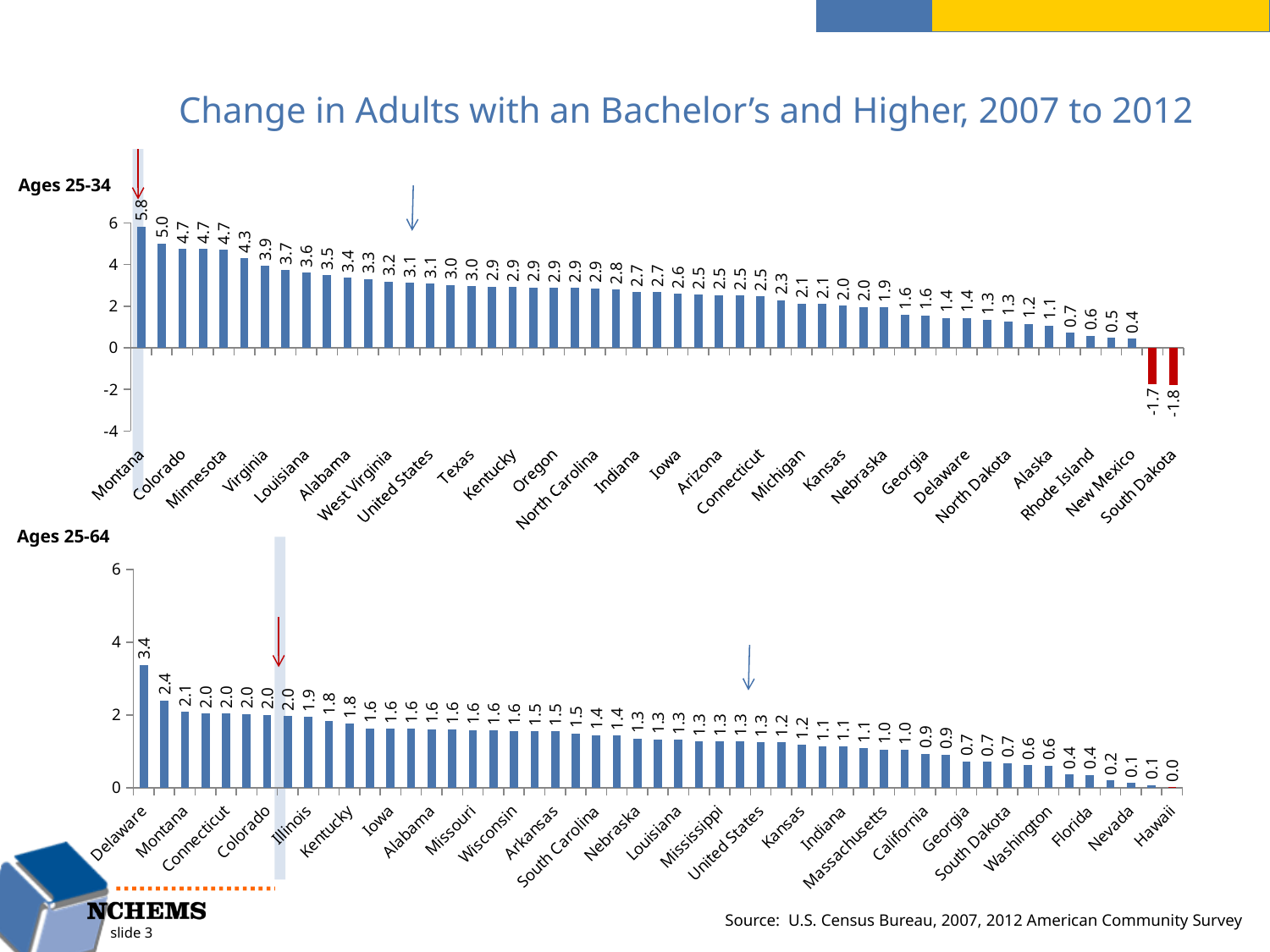
In the 'Ages 25-34' chart, which state has the lowest value? South Dakota In the 'Ages 25-34' chart, what is the difference between the values for Montana and the United States? 2.7 In the 'Ages 25-34' chart, what is the value for South Dakota? -1.8 What kind of chart is the 'Ages 25-34' chart at the top of the slide? bar chart In the 'Ages 25-34' chart, what is the value for the United States? 3.1 In the 'Ages 25-34' chart, what is the value for Montana? 5.8 In the 'Ages 25-34' chart, which state has the highest value? Montana In the 'Ages 25-34' chart, how many bars have negative values? 2 Which is larger: the value for Delaware in the 'Ages 25-64' chart or the value for Montana in the 'Ages 25-34' chart? Montana in the Ages 25-34 chart In the 'Ages 25-64' chart, what is the value for Delaware? 3.4 In the 'Ages 25-64' chart, do the values rise or fall from left to right? fall In the 'Ages 25-64' chart, what is the value for the United States? 1.3